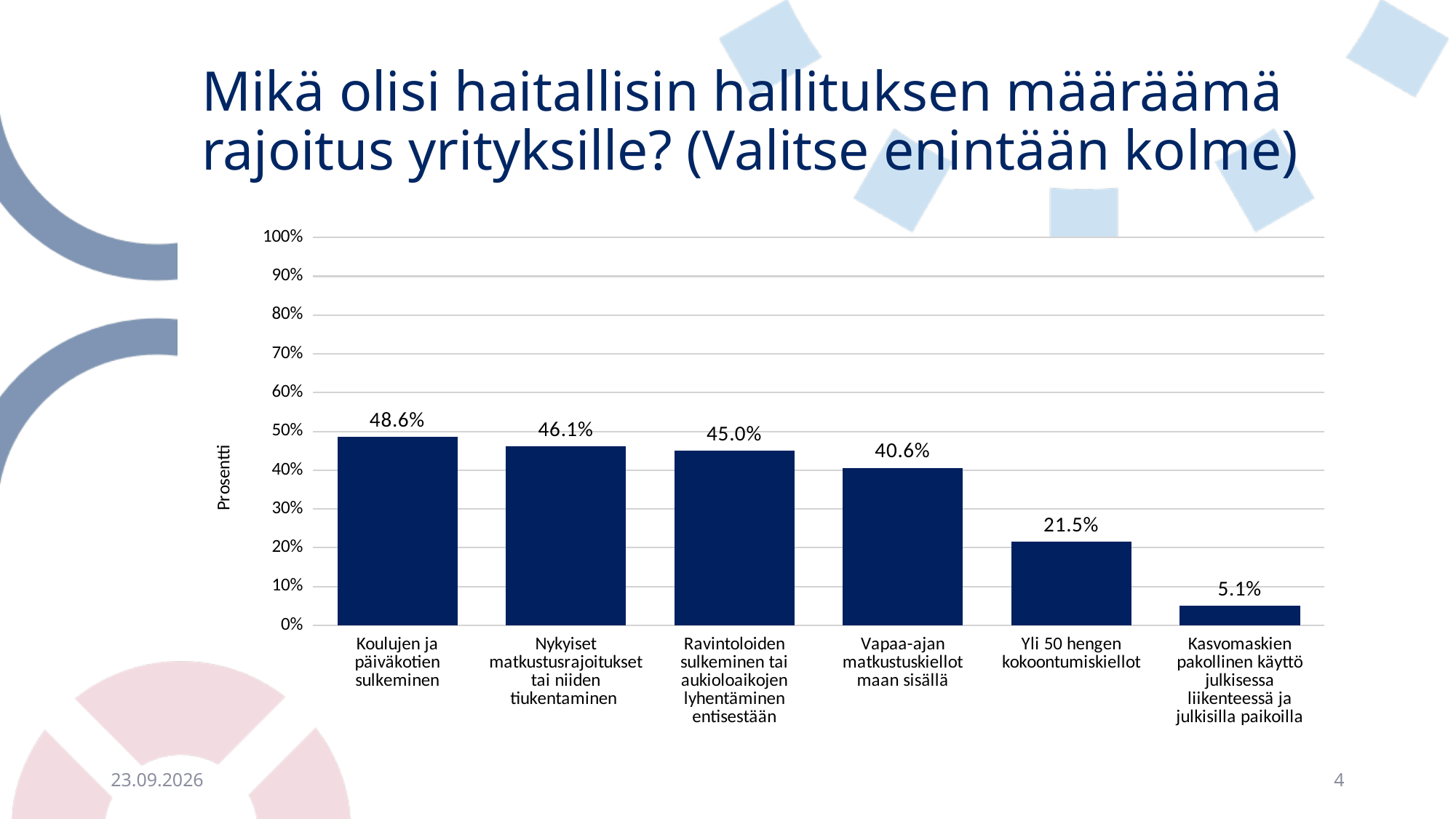
Do the values rise or fall from left to right along the x axis? fall What is the value for "Koulujen ja päiväkotien sulkeminen"? 48.6% How many categories are shown in the chart? 6 What is the difference between the values for "Koulujen ja päiväkotien sulkeminen" and "Yli 50 hengen kokoontumiskiellot"? 27.1% What is the label of the vertical axis? Prosentti Which category has the lowest value? Kasvomaskien pakollinen käyttö julkisessa liikenteessä ja julkisilla paikoilla Which category has the highest value? Koulujen ja päiväkotien sulkeminen What is the value for "Yli 50 hengen kokoontumiskiellot"? 21.5% What kind of chart is shown on the slide? bar chart Is the value for "Ravintoloiden sulkeminen tai aukioloaikojen lyhentäminen entisestään" greater or less than 50%? less What is the value for "Vapaa-ajan matkustuskiellot maan sisällä"? 40.6% Which is larger: the value for "Nykyiset matkustusrajoitukset tai niiden tiukentaminen" or for "Vapaa-ajan matkustuskiellot maan sisällä"? Nykyiset matkustusrajoitukset tai niiden tiukentaminen